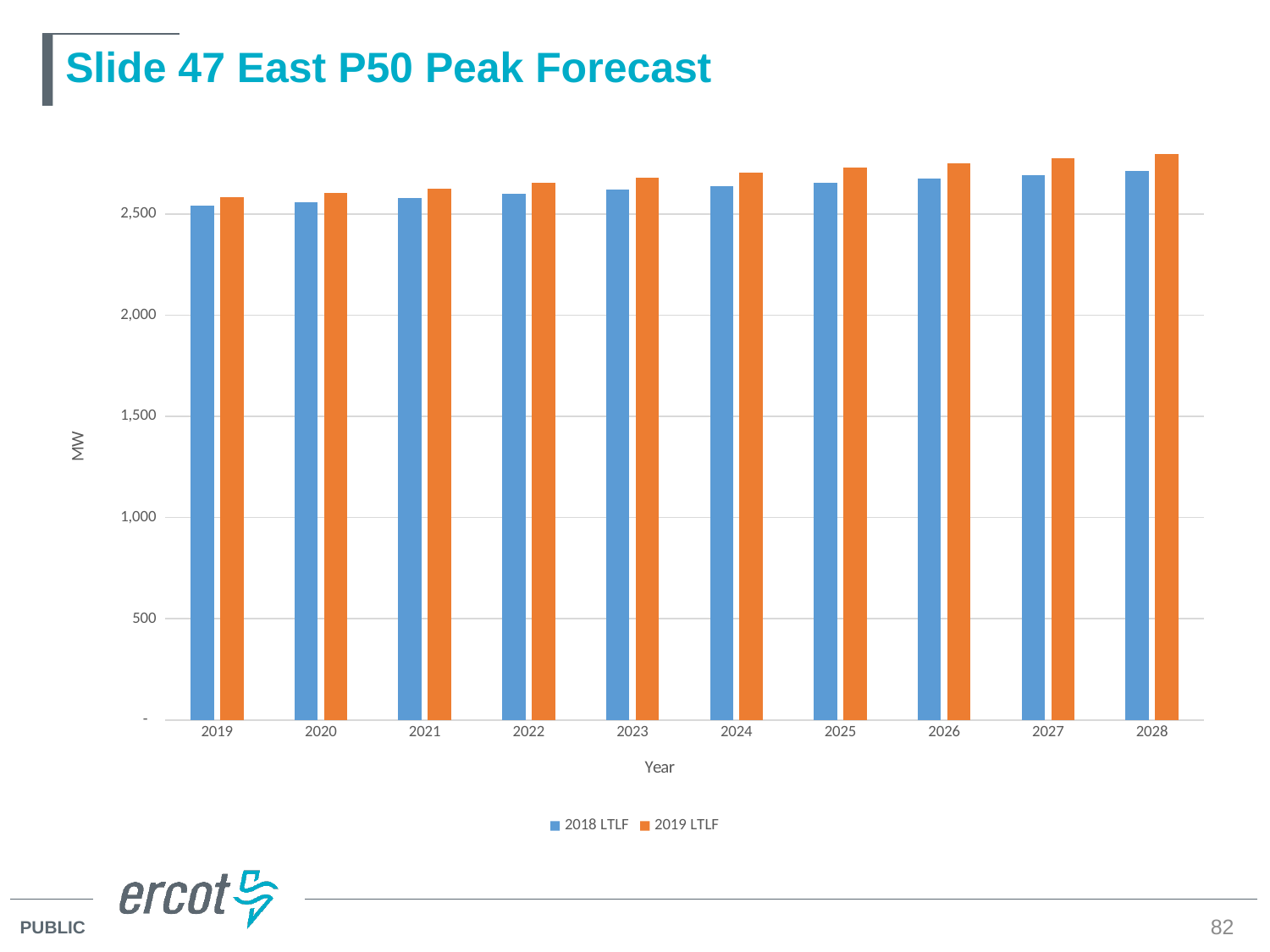
Which series is higher in 2025, 2018 LTLF or 2019 LTLF? 2019 LTLF What is the label on the y axis? MW Which year has the lowest 2018 LTLF value? 2019 Do the 2019 LTLF values rise or fall from 2019 to 2028? rise Which year has the highest 2019 LTLF value? 2028 Which series is higher in 2019, 2018 LTLF or 2019 LTLF? 2019 LTLF Is the 2018 LTLF value for 2024 greater or less than 2,000? greater How many years are shown on the x axis? 10 Which colour represents the 2019 LTLF series? orange Is the 2019 LTLF value for 2028 greater or less than 2,500? greater What kind of chart is shown on the slide? bar chart How many series does the legend list? 2